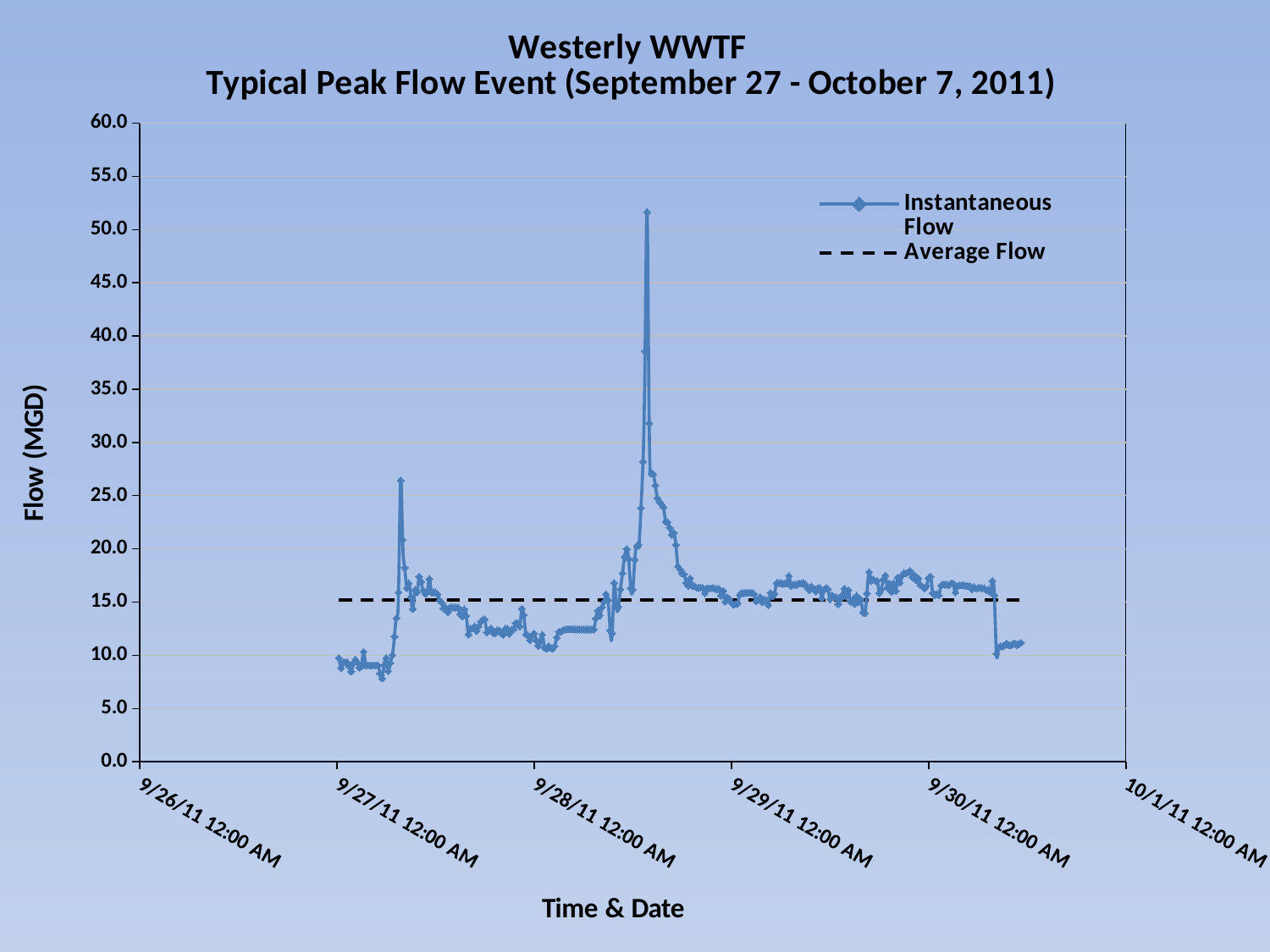
What kind of chart is shown on the slide? line chart Which series reaches the highest value on the chart? Instantaneous Flow What is the label on the vertical axis? Flow (MGD) Is the smaller spike in Instantaneous Flow shortly after 9/27/11 12:00 AM greater or less than 30? less Is the highest peak of the Instantaneous Flow greater or less than 45? greater How many series does the legend list? 2 On which date does the largest spike in Instantaneous Flow occur? 9/28/11 Is the Average Flow line greater or less than 10? greater What are the two series named in the legend? Instantaneous Flow and Average Flow How many date labels are shown on the horizontal axis? 6